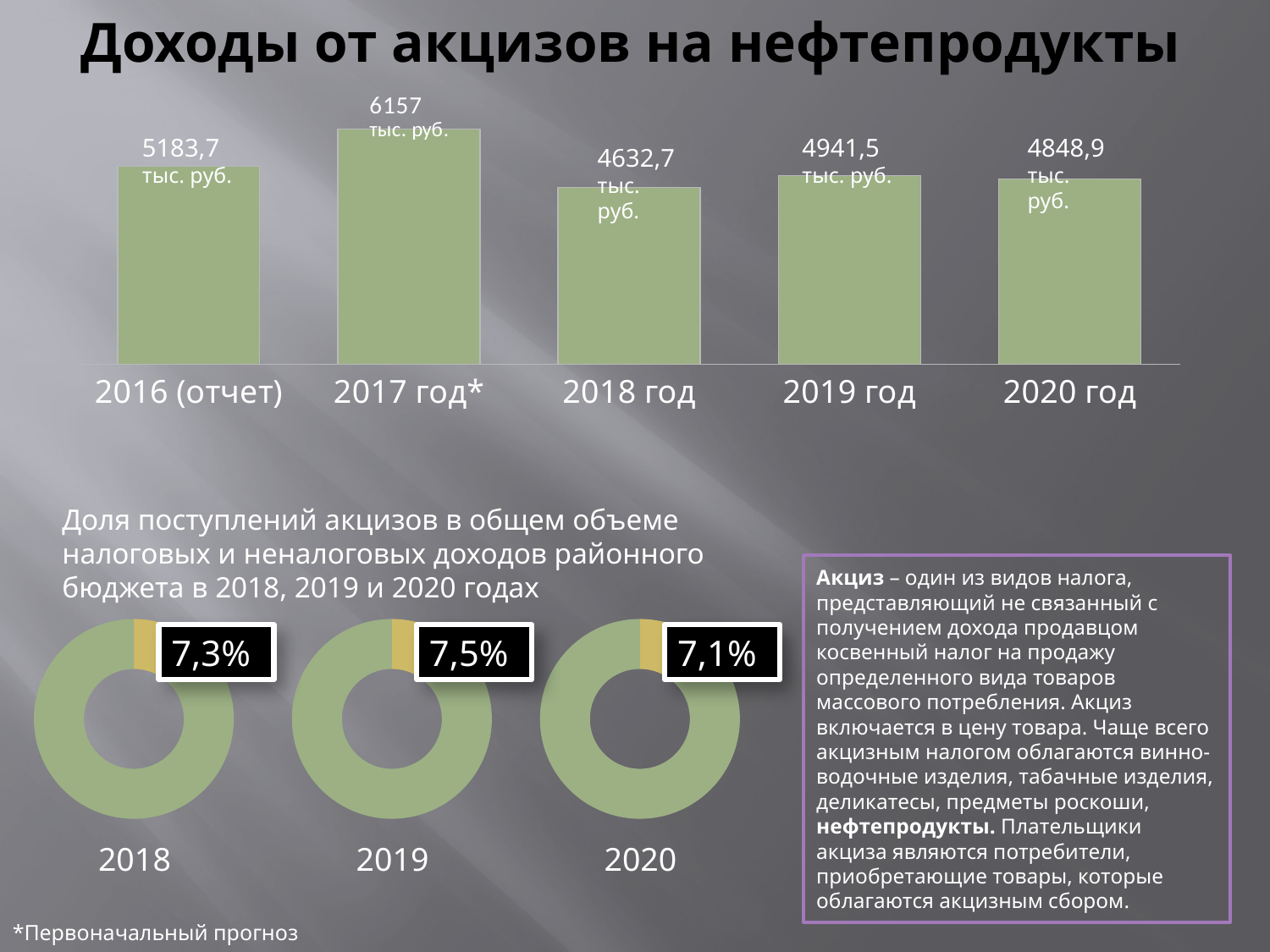
In the bar chart 'Доходы от акцизов на нефтепродукты', which year has the highest value? 2017 год* In the donut charts at the bottom of the slide, what share is shown for 2019? 7,5% How many bars are in the bar chart 'Доходы от акцизов на нефтепродукты'? 5 In the bar chart 'Доходы от акцизов на нефтепродукты', what is the value for 2018 год? 4632,7 тыс. руб. In the donut charts at the bottom of the slide, which year has the smallest share? 2020 In the bar chart 'Доходы от акцизов на нефтепродукты', which is larger: the value for 2019 год or 2018 год? 2019 год What type of chart is used at the top of the slide for 'Доходы от акцизов на нефтепродукты'? Bar chart In the bar chart 'Доходы от акцизов на нефтепродукты', what is the value for 2020 год? 4848,9 тыс. руб. In the bar chart 'Доходы от акцизов на нефтепродукты', what is the value for 2016 (отчет)? 5183,7 тыс. руб. In the bar chart 'Доходы от акцизов на нефтепродукты', which year has the lowest value? 2018 год In the bar chart 'Доходы от акцизов на нефтепродукты', what is the difference between the values for 2017 год* and 2016 (отчет)? 973,3 тыс. руб. In the bar chart 'Доходы от акцизов на нефтепродукты', what is the difference between the values for 2019 год and 2020 год? 92,6 тыс. руб.